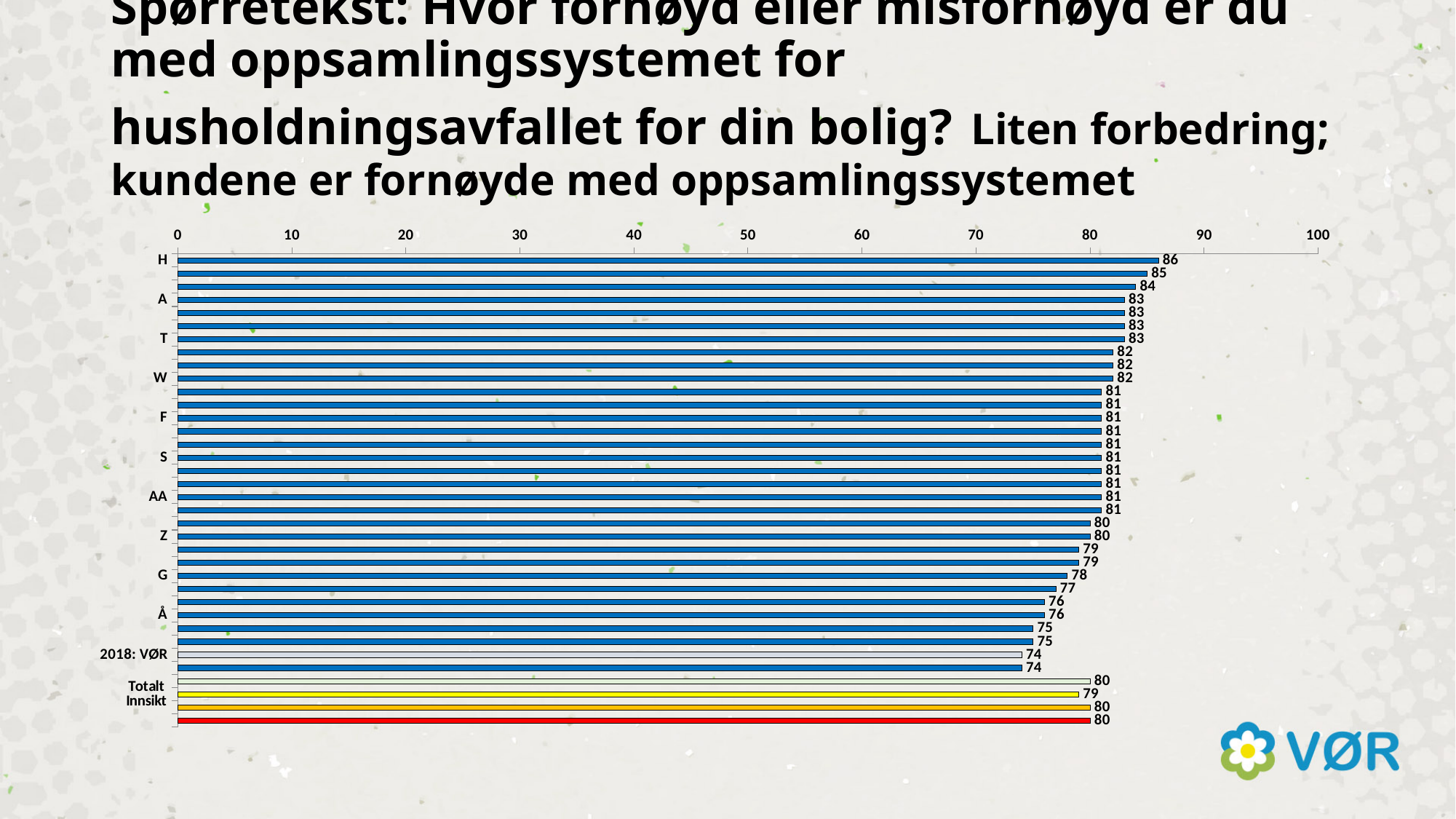
What is the difference between the values for H and 2018: VØR? 12 What kind of chart is shown on the slide? bar chart What value is labeled on the yellow bar at the bottom of the chart? 79 What is the value for G? 78 What is the difference between the values for W and Z? 2 What is the value for Å? 76 Which labeled category has the highest value? H What is the value for Z? 80 Which has a larger value, A or G? A Is the value for W greater or less than 70? greater What is the value for 2018: VØR? 74 What is the value for H? 86